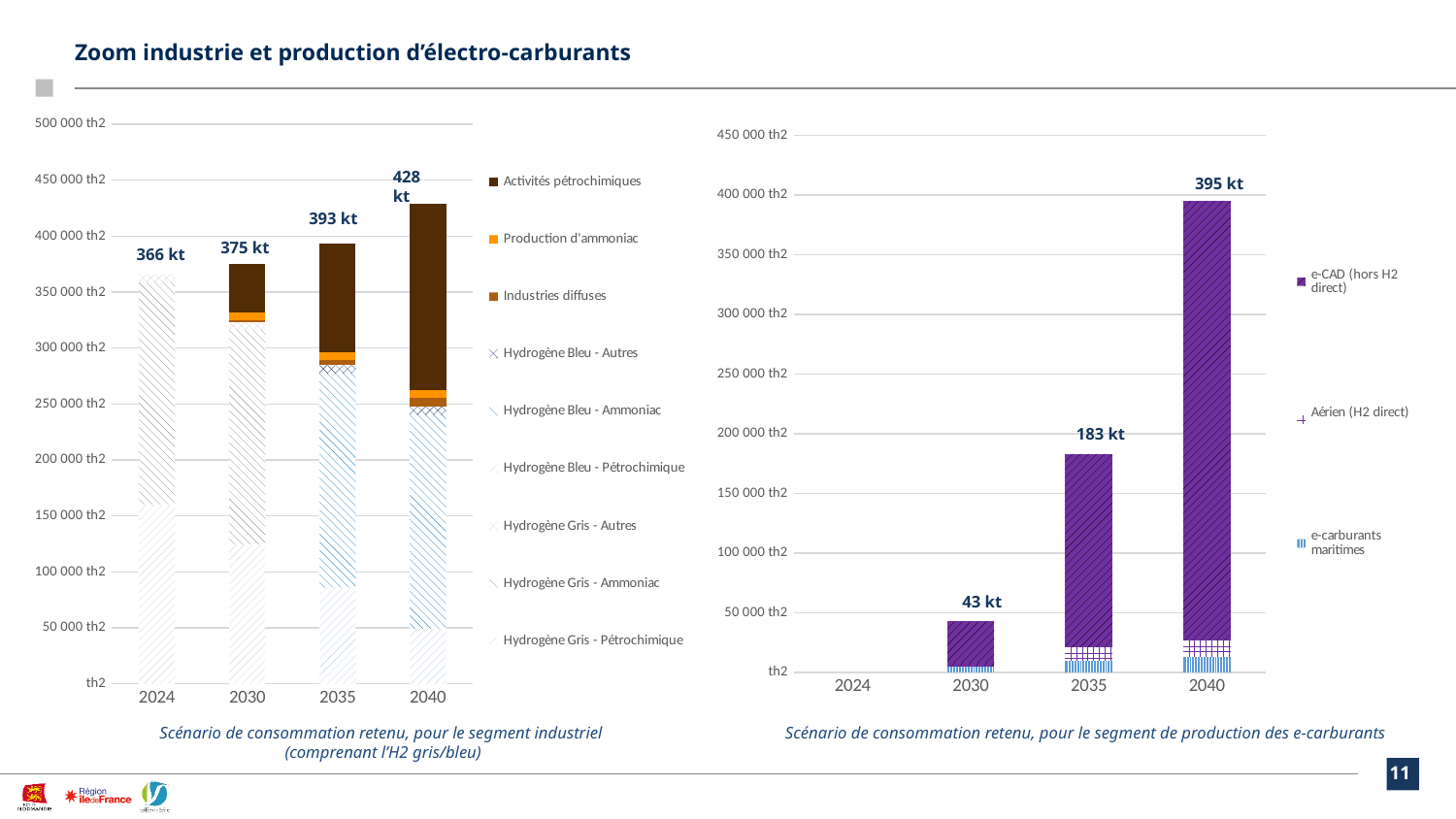
On the right chart (e-carburants production), how many series does the legend list? 3 On the left chart (industrial segment), which year has the highest total? 2040 On the right chart (e-carburants production), what is the total labelled for 2030? 43 kt On the right chart (e-carburants production), what is the total labelled for 2035? 183 kt On the right chart (e-carburants production), what is the difference between the 2040 total and the 2035 total? 212 kt On the left chart (industrial segment), how many series does the legend list? 9 On the left chart (industrial segment), what is the difference between the 2040 total and the 2024 total? 62 kt What kind of chart is the right chart (e-carburants production)? stacked bar chart On the left chart (industrial segment), do the totals rise or fall from 2024 to 2040? rise On the left chart (industrial segment), what is the total labelled for 2024? 366 kt On the left chart (industrial segment), which year has the lowest total? 2024 On the left chart (industrial segment), what is the total labelled for 2040? 428 kt